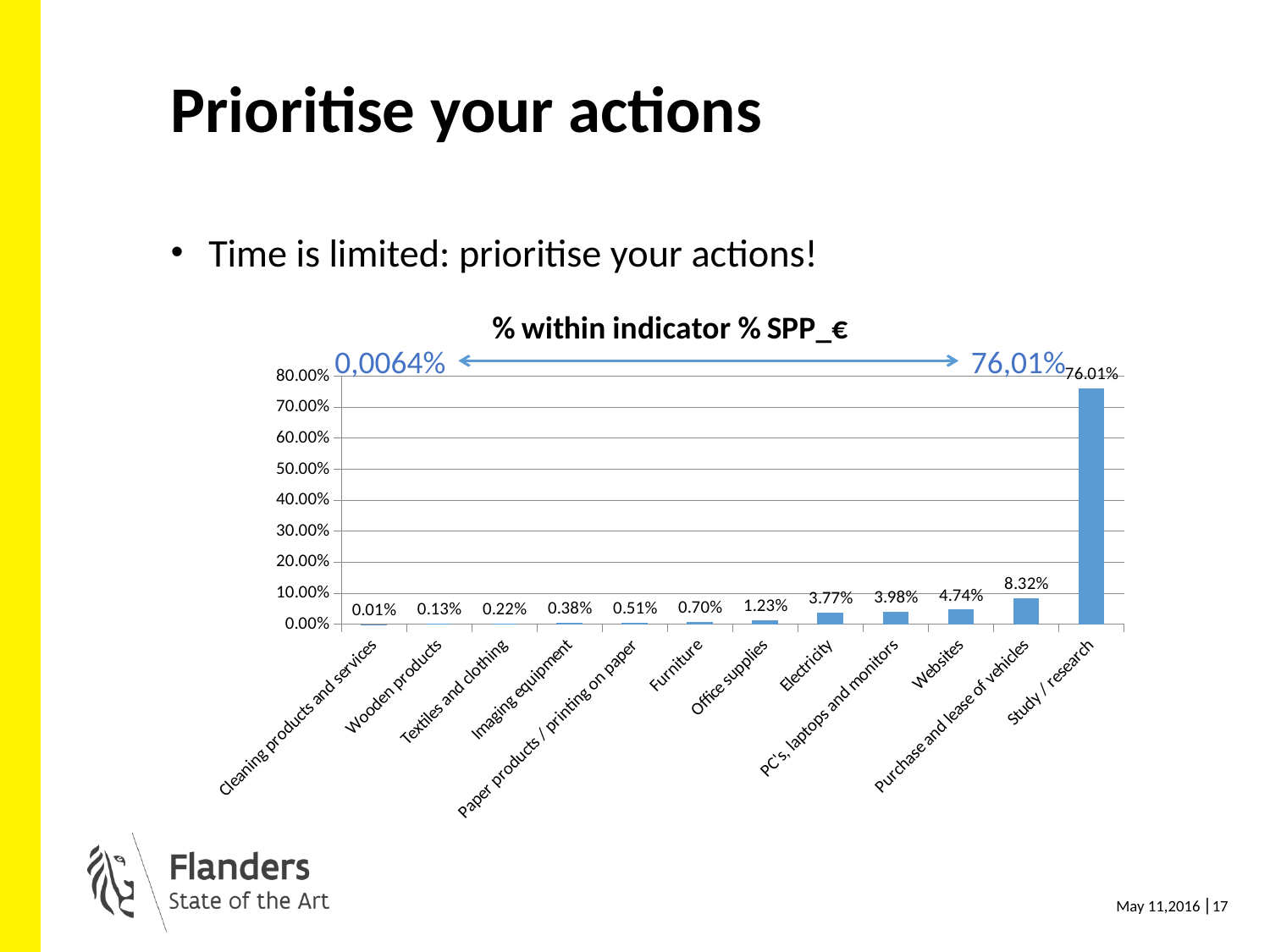
Is the value for Study / research greater or less than 70.00%? greater What is the value for Office supplies? 1.23% How many categories are shown on the x axis? 12 What is the value for Purchase and lease of vehicles? 8.32% What kind of chart is shown on the slide? bar chart What is the value for Electricity? 3.77% Which category has the highest value? Study / research What is the title of the chart? % within indicator % SPP_€ What is the difference between the values for Websites and PC's, laptops and monitors? 0.76% Which category has the lowest value? Cleaning products and services What is the value for Study / research? 76.01% Which is larger, the value for Furniture or the value for Imaging equipment? Furniture